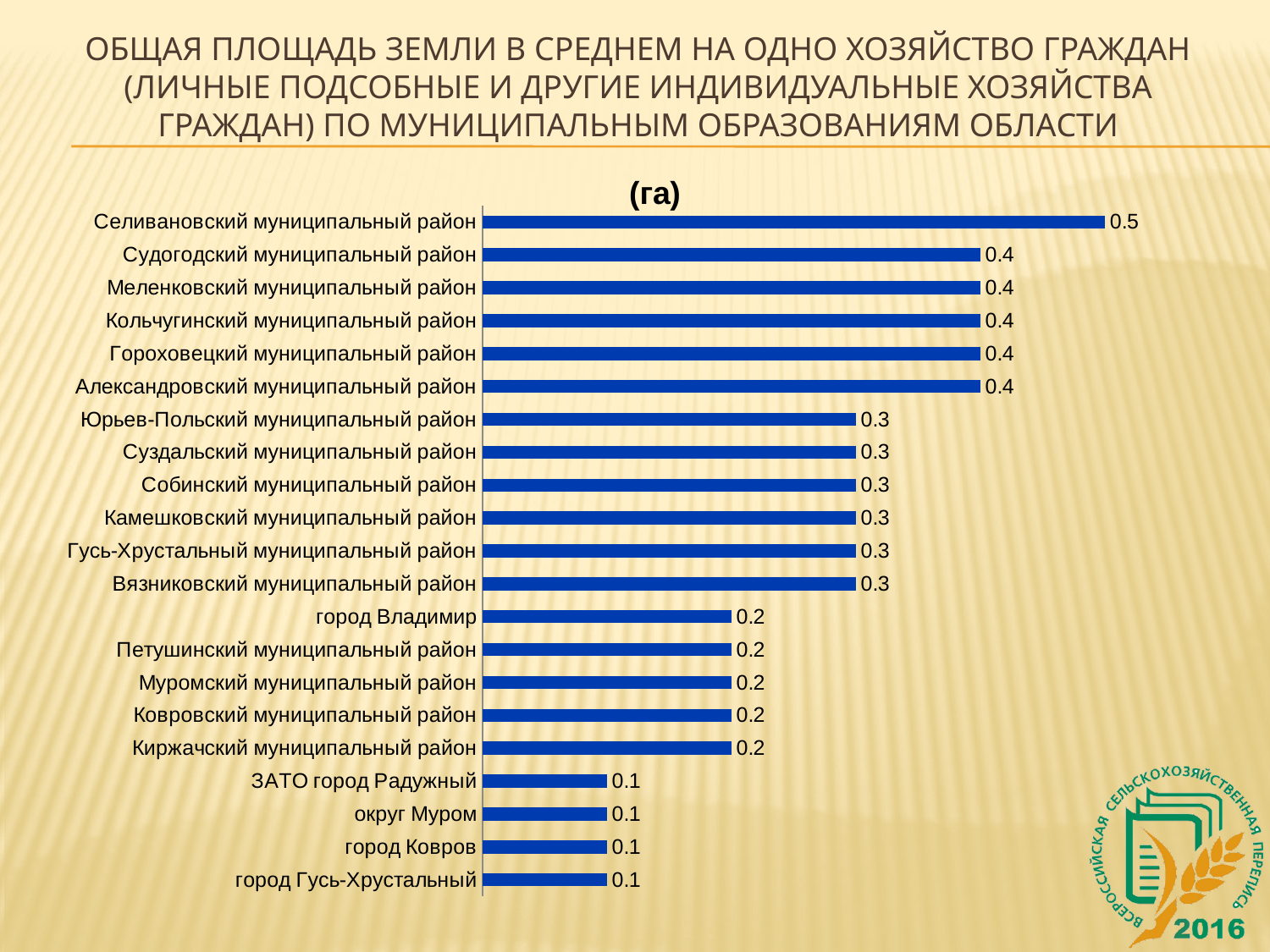
Which is larger, the value for Вязниковский муниципальный район or the value for Муромский муниципальный район? Вязниковский муниципальный район Which category has the highest value? Селивановский муниципальный район What is the value for Александровский муниципальный район? 0.4 What is the value for Суздальский муниципальный район? 0.3 How many categories are shown in the chart? 21 What is the value for город Ковров? 0.1 What is the difference between the values for Селивановский муниципальный район and город Гусь-Хрустальный? 0.4 What kind of chart is shown on the slide? bar chart What is the value for город Владимир? 0.2 What is the value for Селивановский муниципальный район? 0.5 What unit is given in the chart title? га What is the difference between the values for Судогодский муниципальный район and Киржачский муниципальный район? 0.2